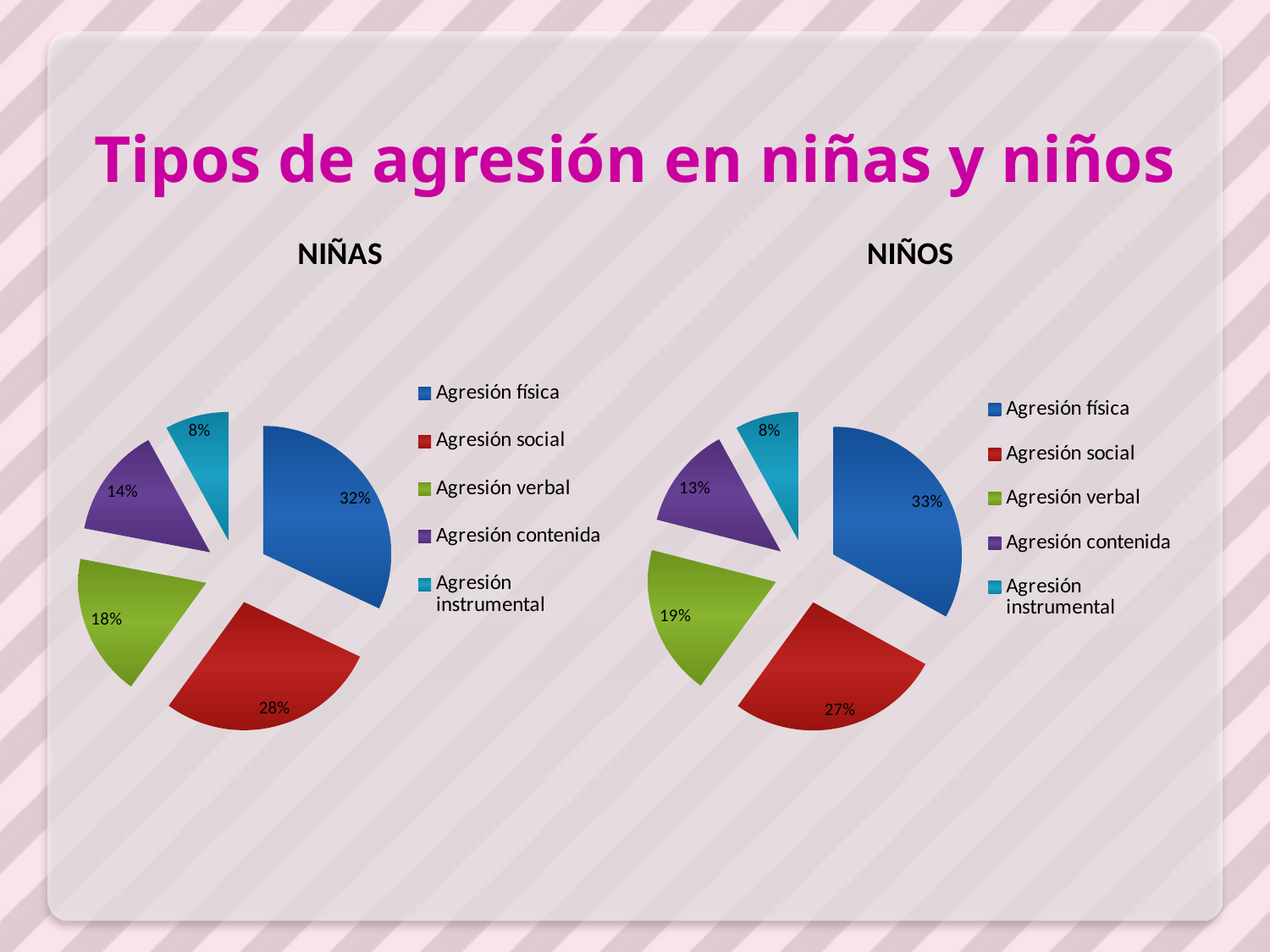
In the NIÑAS chart, what share does Agresión instrumental have? 8% What kind of chart is the NIÑOS chart? Pie chart In the NIÑOS chart, what share does Agresión social have? 27% In the NIÑOS chart, which is larger, Agresión verbal or Agresión contenida? Agresión verbal In the NIÑAS chart, what is the difference between Agresión social and Agresión verbal? 10% In the NIÑOS chart, what colour is the Agresión verbal slice? Green How many slices does the NIÑAS chart have? 5 In the NIÑOS chart, which category has the smallest slice? Agresión instrumental How many entries does the legend of the NIÑAS chart list? 5 In the NIÑAS chart, what share does Agresión física have? 32% In the NIÑAS chart, which category has the largest slice? Agresión física